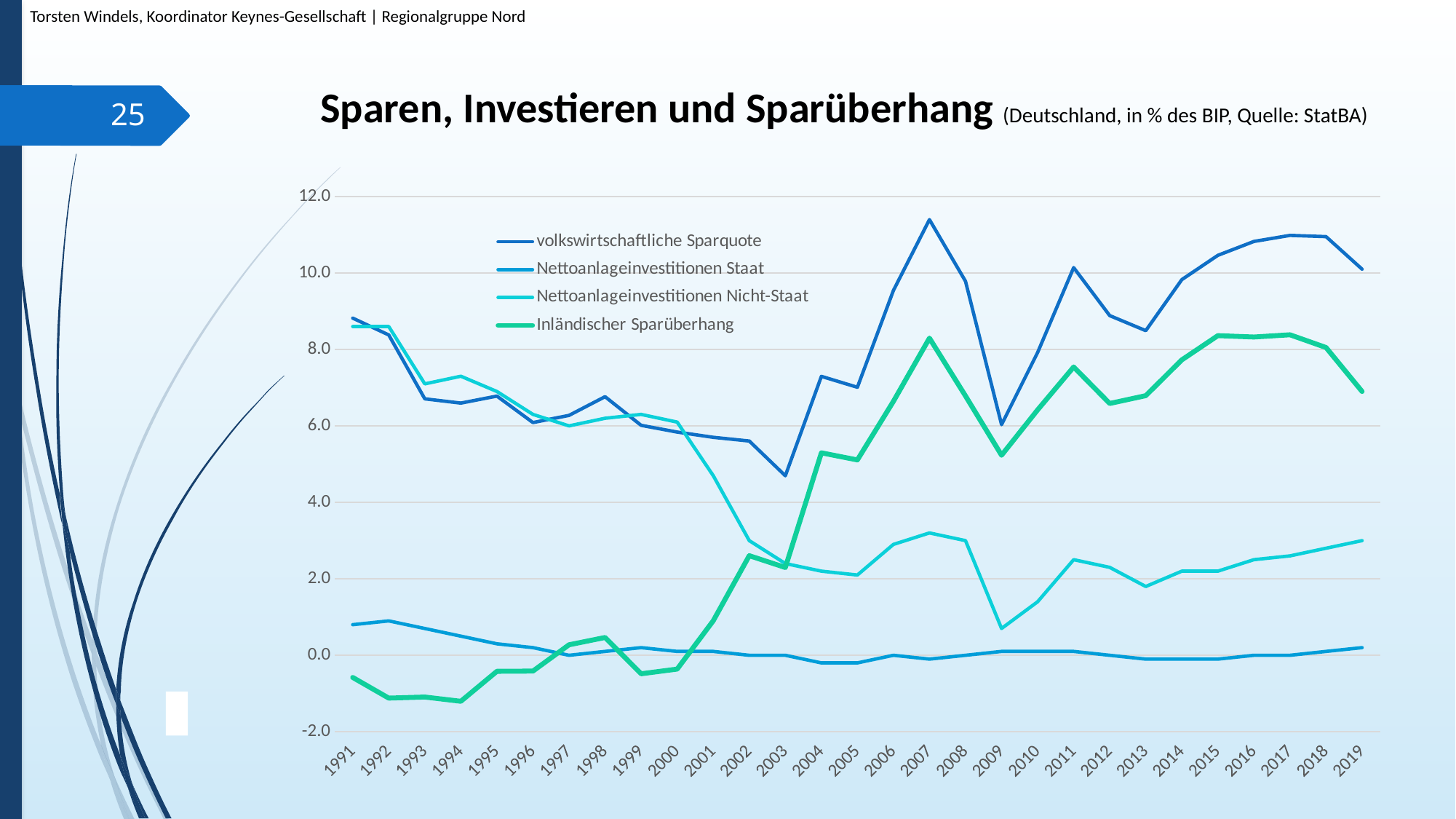
In 2019, which is higher: the volkswirtschaftliche Sparquote or the Inländischer Sparüberhang? volkswirtschaftliche Sparquote What kind of chart is shown on the slide? line chart Is the value of the volkswirtschaftliche Sparquote in 2007 greater or less than 10.0? greater In 2001, which is higher: Nettoanlageinvestitionen Nicht-Staat or Inländischer Sparüberhang? Nettoanlageinvestitionen Nicht-Staat In which year does the volkswirtschaftliche Sparquote reach its highest value? 2007 What is the title of the chart? Sparen, Investieren und Sparüberhang In which year does the volkswirtschaftliche Sparquote reach its lowest value? 2003 How many series does the legend list? 4 Is the value of the Inländischer Sparüberhang in 1994 greater or less than 0.0? less Is the value of Nettoanlageinvestitionen Nicht-Staat in 2009 greater or less than 2.0? less How many years are plotted along the x axis? 29 Does the Inländischer Sparüberhang rise or fall between 2003 and 2007? rise